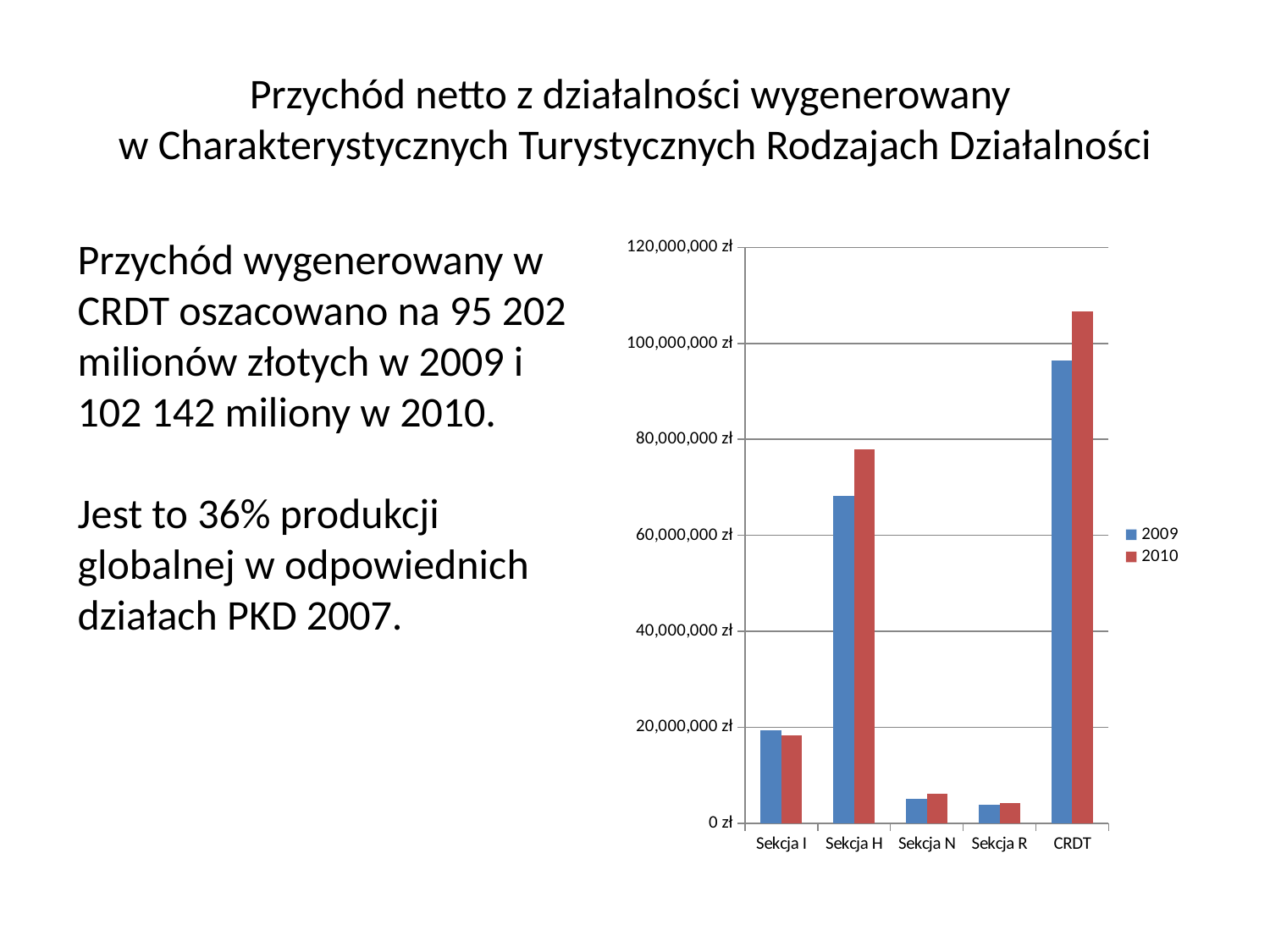
What kind of chart is shown on the slide? bar chart Which category has the lowest value for 2009? Sekcja R Which is larger for Sekcja H: the 2009 value or the 2010 value? 2010 Is the 2009 value for Sekcja H greater or less than 80,000,000 zł? less Is the 2010 value for CRDT greater or less than 100,000,000 zł? greater Which series is shown in red in the chart? 2010 Which category has the highest value for 2010? CRDT How many series does the chart legend list? 2 How many categories are shown on the x axis of the chart? 5 Is the 2009 value for Sekcja N greater or less than 20,000,000 zł? less What is the highest value shown on the chart's vertical axis? 120,000,000 zł Which is larger for Sekcja I: the 2009 value or the 2010 value? 2009